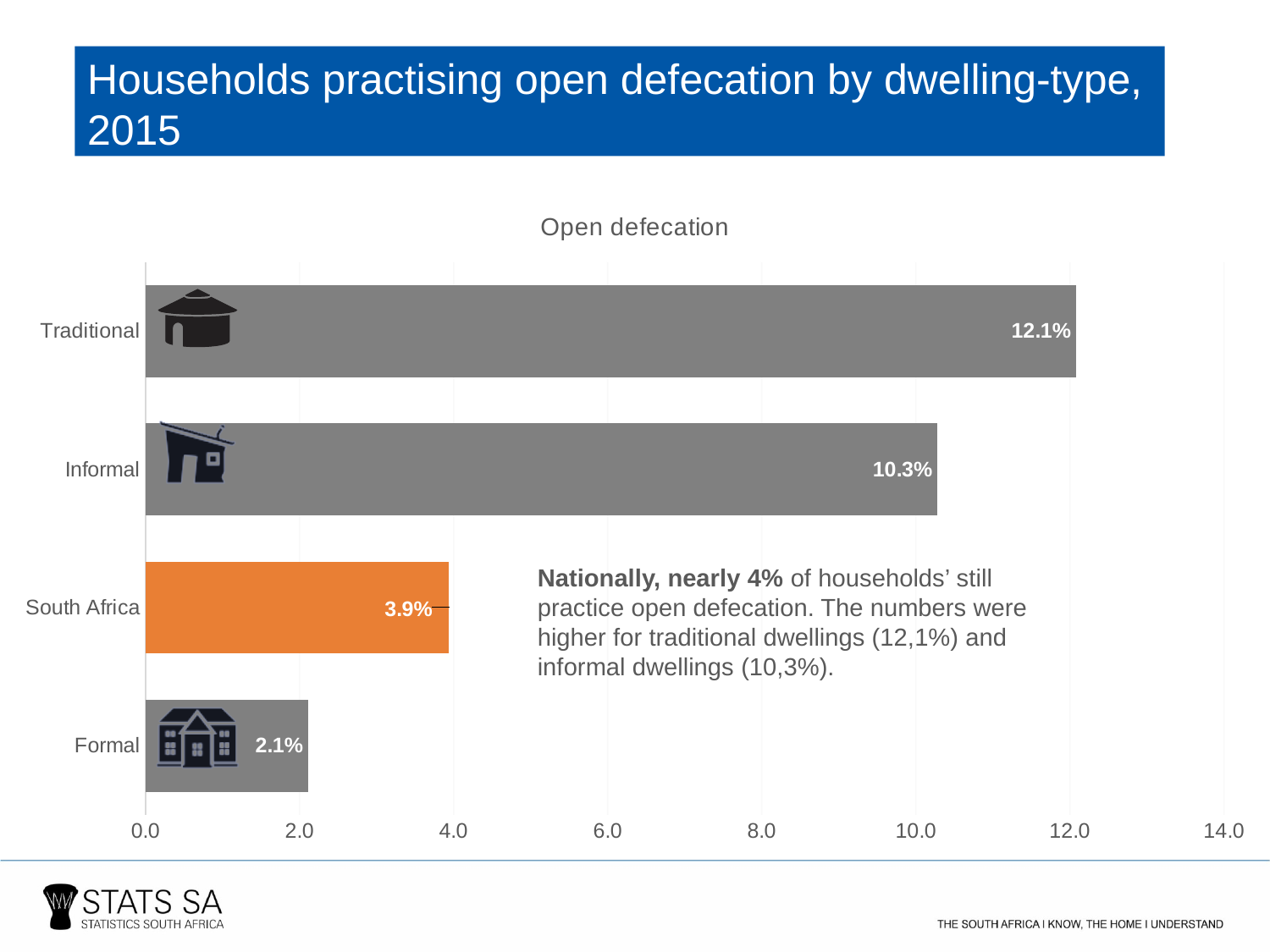
Which dwelling type has the highest share of households practising open defecation? Traditional How many categories are shown on the chart? 4 What is the value for Informal dwellings? 10.3% Is the value for Traditional greater or less than 10.0? greater Which is larger, the value for Informal or the value for South Africa? Informal What is the value for South Africa? 3.9% What is the value for Traditional dwellings? 12.1% What is the value for Formal dwellings? 2.1% What kind of chart is shown on the slide? Bar chart What is the difference between the Traditional and Informal values? 1.8% Which category has the lowest value? Formal What is the difference between the South Africa and Formal values? 1.8%